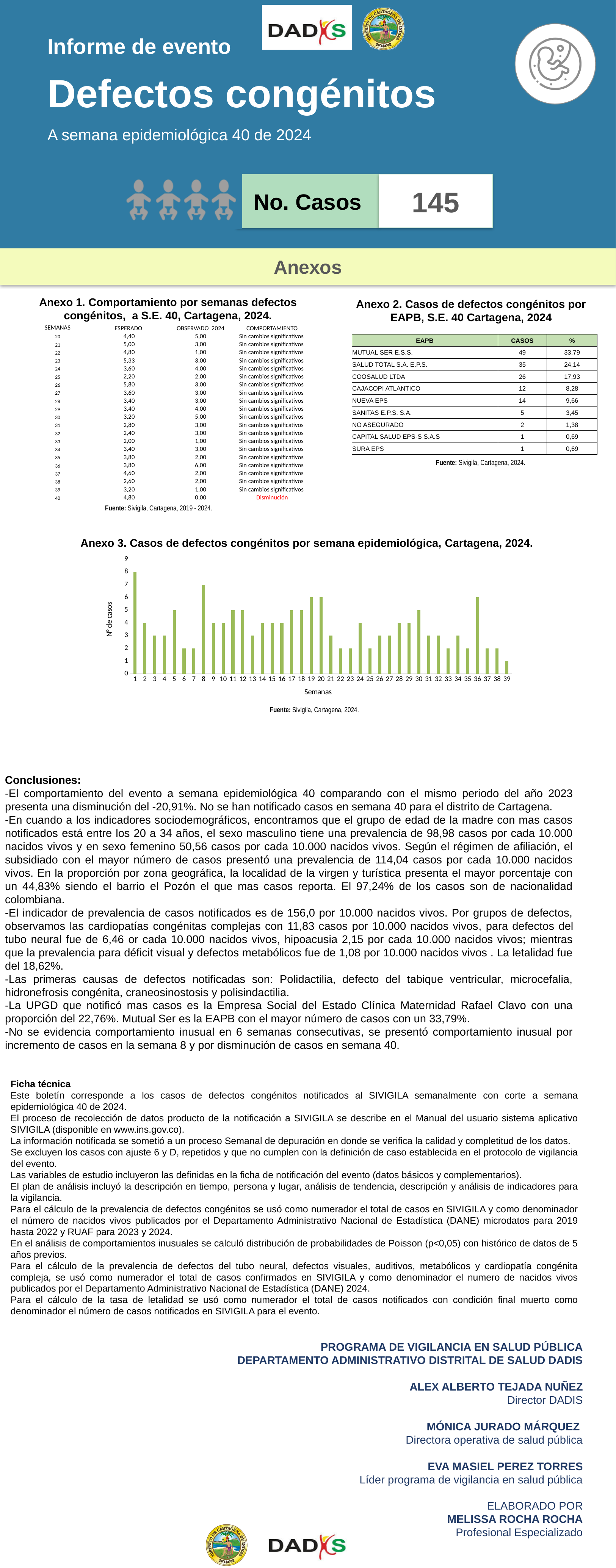
In the Anexo 3 chart, which week has the lowest number of cases? 39 In the Anexo 3 chart, how many cases are shown for week 39? 1 What kind of chart is shown in Anexo 3? bar chart What is the label of the y axis in the Anexo 3 chart? Nº de casos In the Anexo 3 chart, how many cases are shown for week 1? 8 In the Anexo 3 chart, how many weeks are plotted on the x axis? 39 In the Anexo 3 chart, how many cases are shown for week 8? 7 In the Anexo 3 chart, is the value for week 1 greater or less than 5? greater In the Anexo 3 chart, which has more cases, week 1 or week 8? week 1 In the Anexo 3 chart, which week has the highest number of cases? 1 In the Anexo 3 chart, which has more cases, week 36 or week 39? week 36 In the Anexo 3 chart, is the value for week 39 greater or less than 2? less